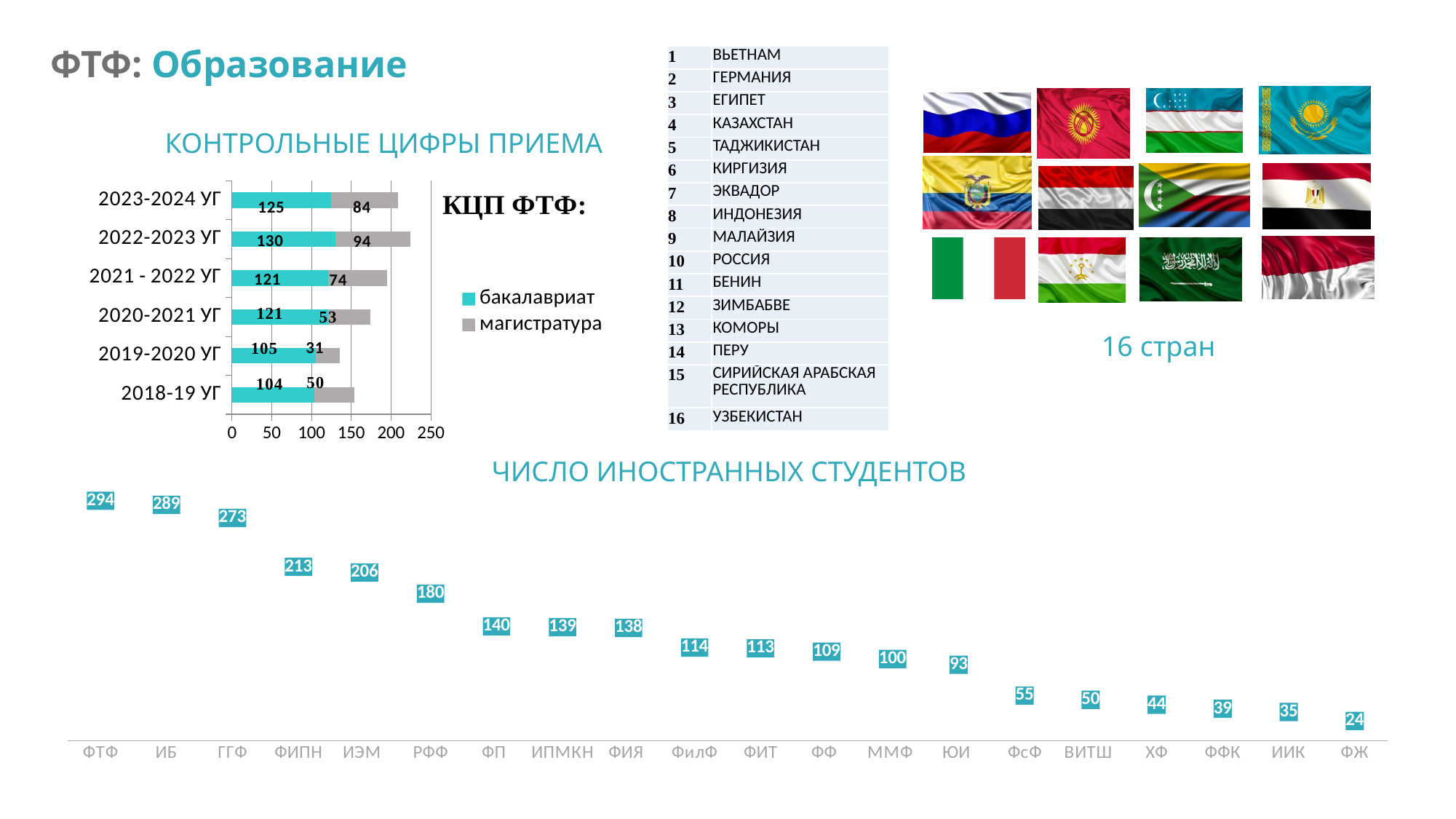
In the chart 'КОНТРОЛЬНЫЕ ЦИФРЫ ПРИЕМА', what is the total of the stacked bar for 2023-2024 УГ? 209 In the chart 'КОНТРОЛЬНЫЕ ЦИФРЫ ПРИЕМА', how many series does the legend list? 2 In the chart 'КОНТРОЛЬНЫЕ ЦИФРЫ ПРИЕМА', what is the магистратура value for 2019-2020 УГ? 31 In the chart 'КОНТРОЛЬНЫЕ ЦИФРЫ ПРИЕМА', what is the difference between the бакалавриат values for 2022-2023 УГ and 2018-19 УГ? 26 In the chart 'ЧИСЛО ИНОСТРАННЫХ СТУДЕНТОВ', how many categories are shown on the x axis? 20 In the chart 'ЧИСЛО ИНОСТРАННЫХ СТУДЕНТОВ', do the values rise or fall from left to right along the x axis? Fall In the chart 'ЧИСЛО ИНОСТРАННЫХ СТУДЕНТОВ', what is the value for ИЭМ? 206 In the chart 'КОНТРОЛЬНЫЕ ЦИФРЫ ПРИЕМА', which year has the highest магистратура value? 2022-2023 УГ In the chart 'КОНТРОЛЬНЫЕ ЦИФРЫ ПРИЕМА', what is the бакалавриат value for 2022-2023 УГ? 130 In the chart 'ЧИСЛО ИНОСТРАННЫХ СТУДЕНТОВ', what is the difference between the values for ФТФ and ИБ? 5 What kind of chart is 'КОНТРОЛЬНЫЕ ЦИФРЫ ПРИЕМА'? Stacked bar chart In the chart 'ЧИСЛО ИНОСТРАННЫХ СТУДЕНТОВ', which category has the lowest value? ФЖ